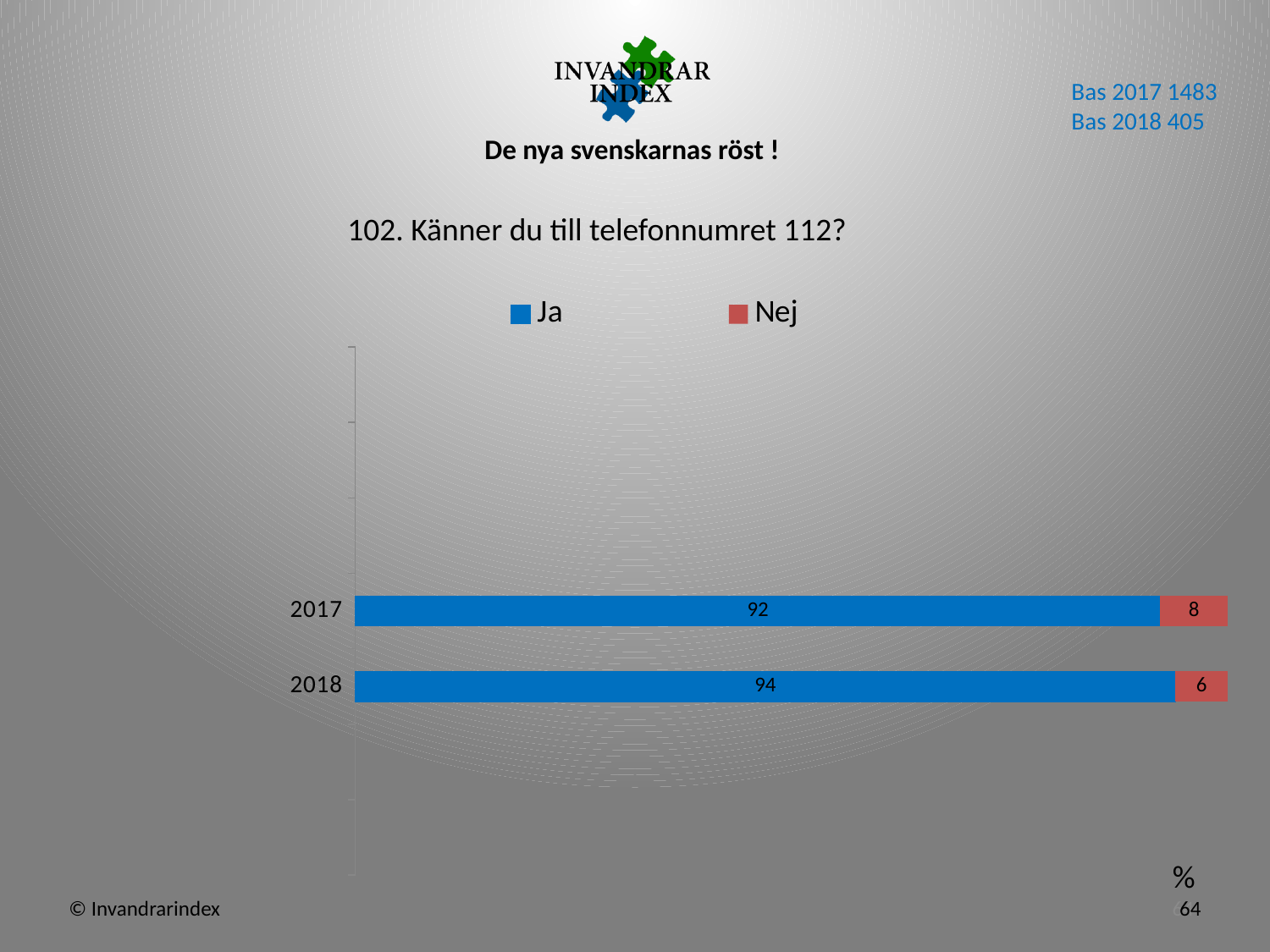
What is the difference between the Ja values for 2018 and 2017? 2 Is the Nej value for 2017 larger or smaller than the Nej value for 2018? larger What is the value for Ja in 2018? 94 How many years are shown in the chart? 2 Which year has the higher value for Ja? 2018 What is the total of the stacked bar for 2017? 100 Which year has the lower value for Nej? 2018 What is the value for Nej in 2017? 8 What is the value for Ja in 2017? 92 What is the value for Nej in 2018? 6 How many series does the legend list? 2 What kind of chart is shown on the slide? stacked bar chart